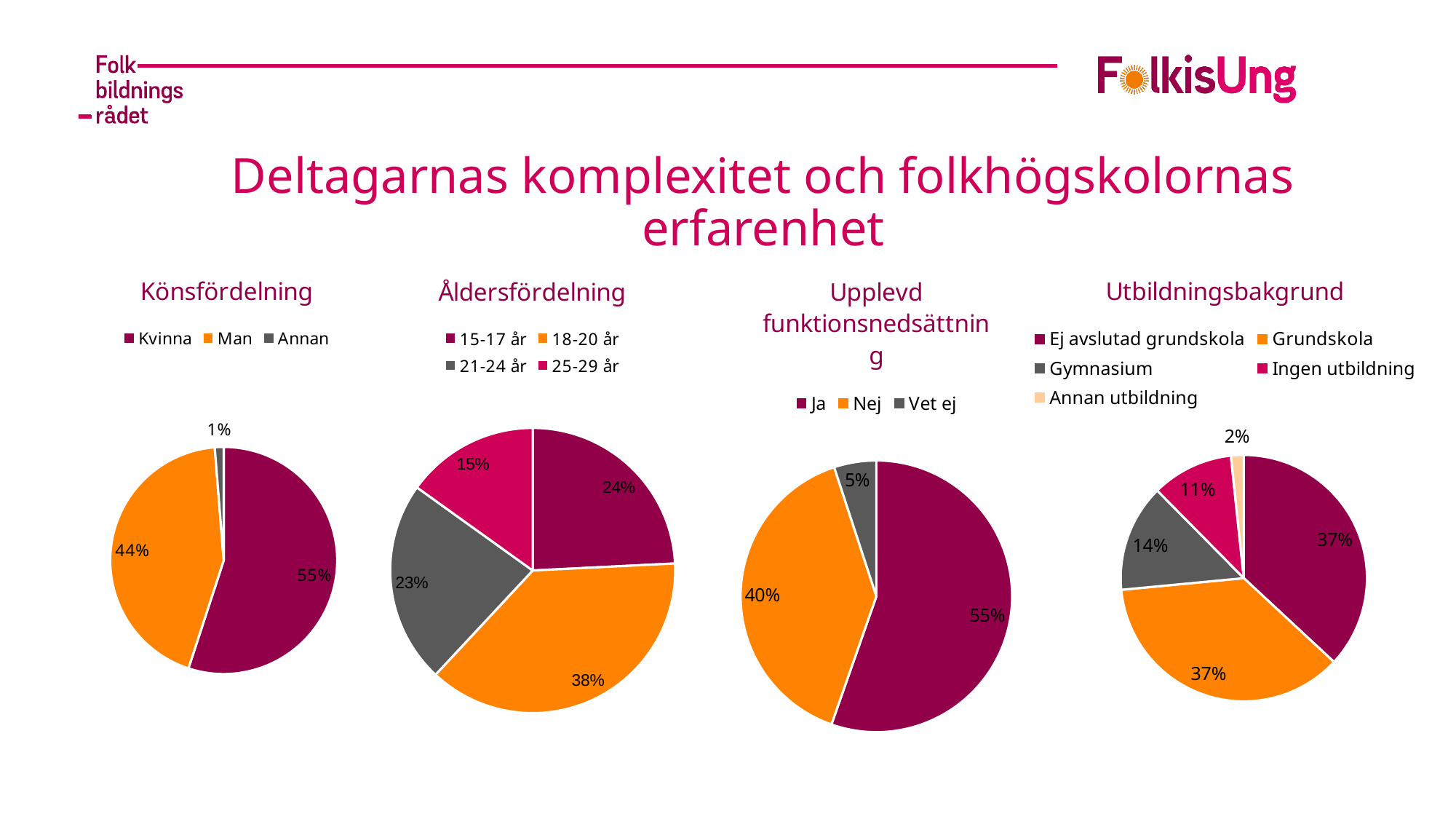
In the Utbildningsbakgrund chart, what is the value for Gymnasium? 14% In the Könsfördelning chart, which category has the smallest slice? Annan In the Åldersfördelning chart, which age group has the largest slice? 18-20 år In the Könsfördelning chart, what share of the pie is Kvinna? 55% In the Utbildningsbakgrund chart, which category has the smallest slice? Annan utbildning In the Åldersfördelning chart, what is the difference between the 18-20 år and 21-24 år slices? 15% In the Upplevd funktionsnedsättning chart, which is larger, Ja or Nej? Ja How many categories does the Åldersfördelning pie chart show? 4 In the Åldersfördelning chart, what is the value for 25-29 år? 15% What type of chart is used for Utbildningsbakgrund? Pie chart In the Upplevd funktionsnedsättning chart, what is the value for Nej? 40% In the Könsfördelning chart, what is the value for Man? 44%